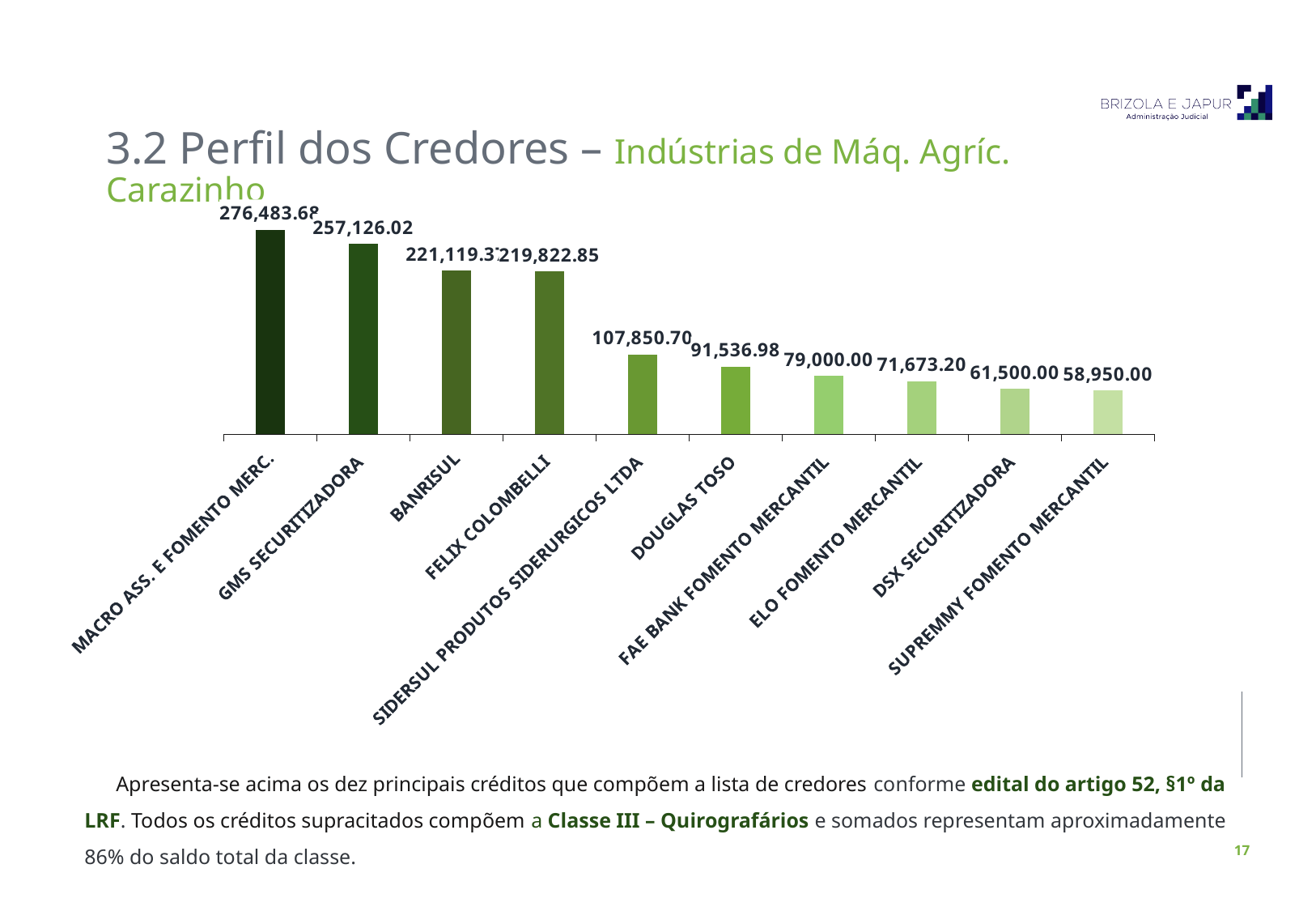
What is the value for GMS SECURITIZADORA? 257,126.02 What kind of chart is shown on the slide? bar chart Do the values rise or fall from left to right along the x axis? fall What is the value for ELO FOMENTO MERCANTIL? 71,673.20 What is the value for FELIX COLOMBELLI? 219,822.85 What is the difference between the values for GMS SECURITIZADORA and FELIX COLOMBELLI? 37,303.17 Which is larger, the value for FAE BANK FOMENTO MERCANTIL or the value for DSX SECURITIZADORA? FAE BANK FOMENTO MERCANTIL Which creditor has the lowest value in the chart? SUPREMMY FOMENTO MERCANTIL What is the value for SIDERSUL PRODUTOS SIDERURGICOS LTDA? 107,850.70 What is the value for DOUGLAS TOSO? 91,536.98 How many creditors (categories) are shown in the chart? 10 Which creditor has the highest value in the chart? MACRO ASS. E FOMENTO MERC.